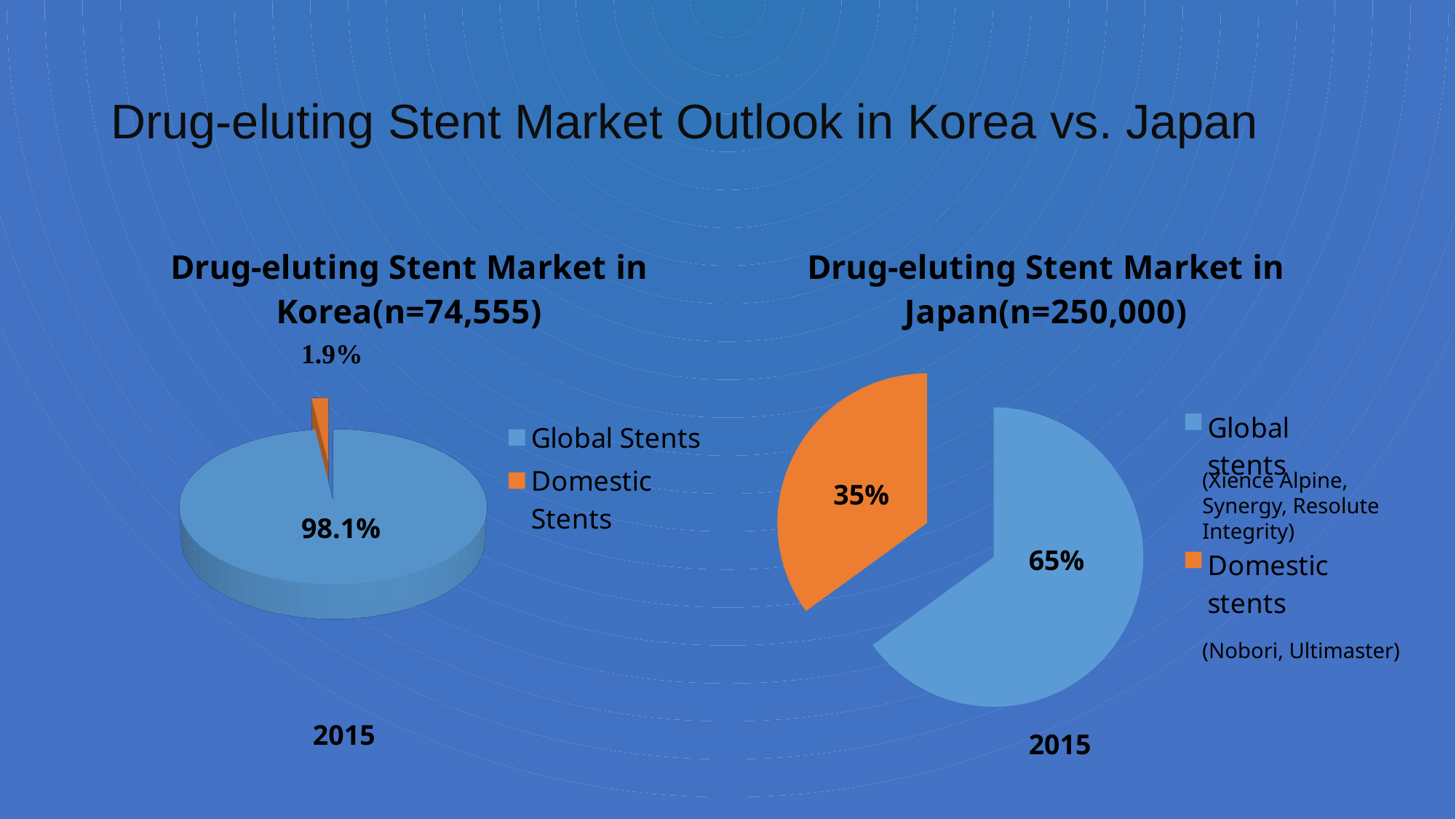
In the Korea chart, what colour is the Domestic Stents slice? Orange In the Korea chart, what is the difference in percentage points between Global Stents and Domestic Stents? 96.2 In the Korea chart, what share of the market do Domestic Stents hold? 1.9% In the Japan chart, what share of the market do Domestic stents hold? 35% In the Japan chart, what is the difference in percentage points between Global stents and Domestic stents? 30 In the Japan chart, what share of the market do Global stents hold? 65% What is the sample size (n) shown in the title of the Japan chart? 250,000 In the Japan chart, which slice is larger, Global stents or Domestic stents? Global stents What kind of chart is the Korea chart? Pie chart How many series does the legend of the Japan chart list? 2 In the Korea chart, what share of the drug-eluting stent market do Global Stents hold? 98.1% In the Korea chart, which category has the smallest slice? Domestic Stents